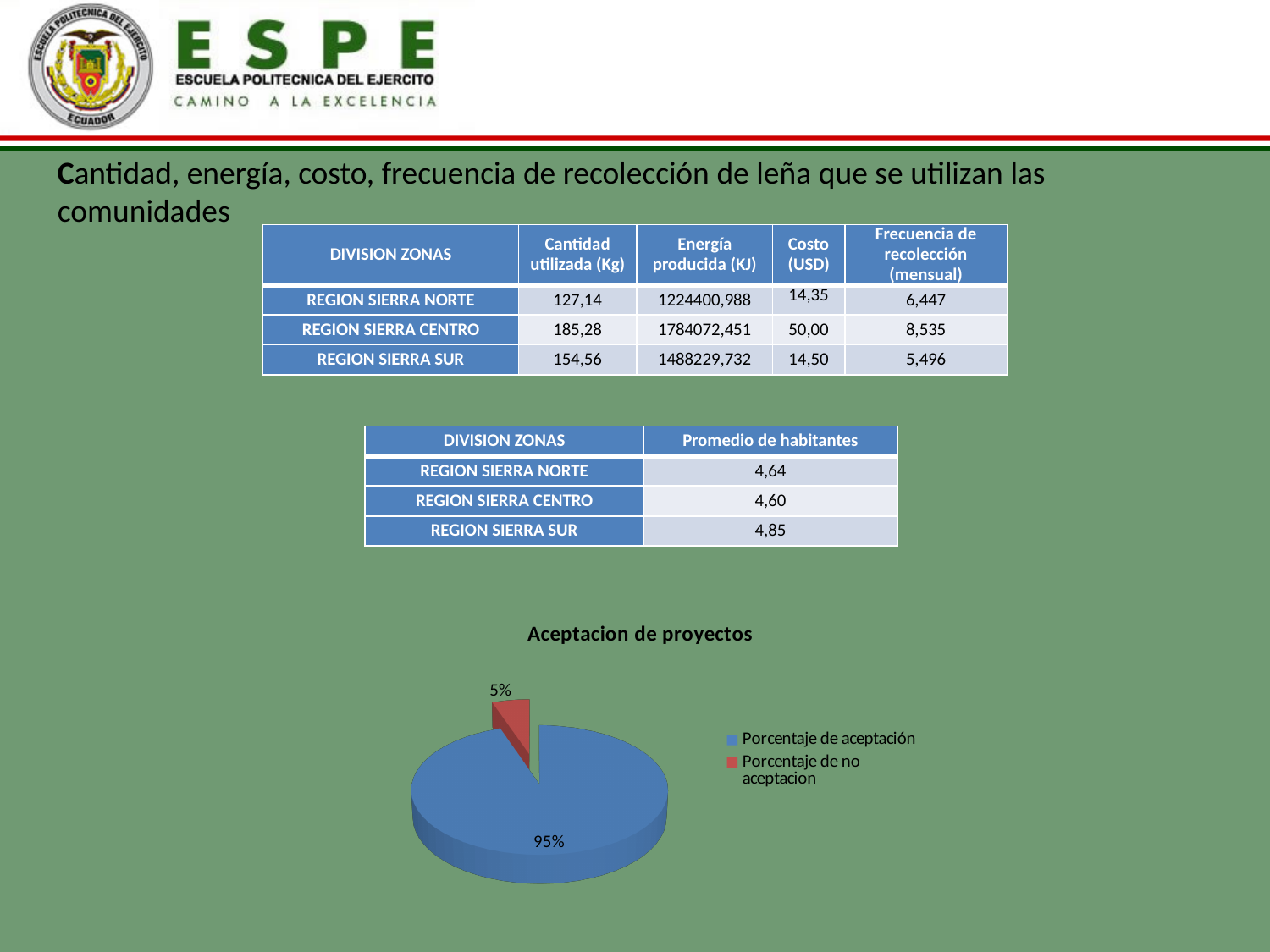
In the "Aceptacion de proyectos" pie chart, what colour is the "Porcentaje de no aceptacion" slice? red How many entries does the legend of the "Aceptacion de proyectos" pie chart list? 2 In the "Aceptacion de proyectos" pie chart, what share is labelled for "Porcentaje de no aceptacion"? 5% Which slice of the "Aceptacion de proyectos" pie chart is the smallest? Porcentaje de no aceptacion What kind of chart is shown under the title "Aceptacion de proyectos"? pie chart In the "Aceptacion de proyectos" pie chart, what is the difference in percentage points between the acceptance slice and the non-acceptance slice? 90 percentage points In the "Aceptacion de proyectos" pie chart, what share is labelled for "Porcentaje de aceptación"? 95% What is the title of the pie chart on the slide? Aceptacion de proyectos Which slice of the "Aceptacion de proyectos" pie chart is the largest? Porcentaje de aceptación In the "Aceptacion de proyectos" pie chart, which is larger: "Porcentaje de aceptación" or "Porcentaje de no aceptacion"? Porcentaje de aceptación How many slices does the "Aceptacion de proyectos" pie chart have? 2